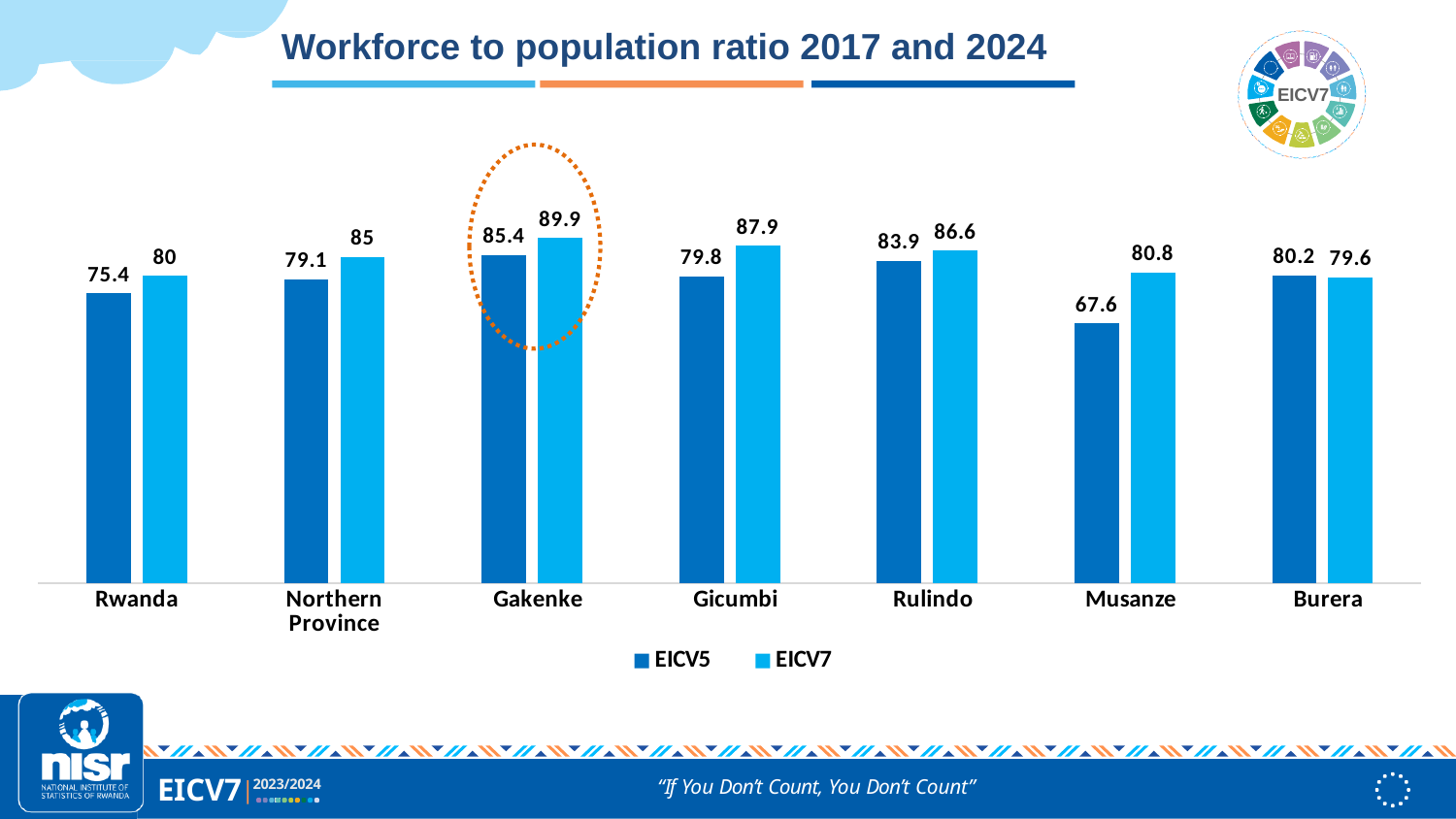
What kind of chart is shown on the slide? Bar chart What is the difference between the EICV7 and EICV5 values for Gicumbi? 8.1 How many categories are shown on the x axis? 7 Which category has the highest EICV7 value? Gakenke What is the EICV5 value for Musanze? 67.6 What is the difference between the EICV7 and EICV5 values for Musanze? 13.2 How many series does the legend list? 2 What is the EICV5 value for Rwanda? 75.4 For Burera, which is larger, the EICV5 value or the EICV7 value? EICV5 Which category has the lowest EICV5 value? Musanze What is the EICV7 value for Gakenke? 89.9 What is the EICV7 value for Northern Province? 85